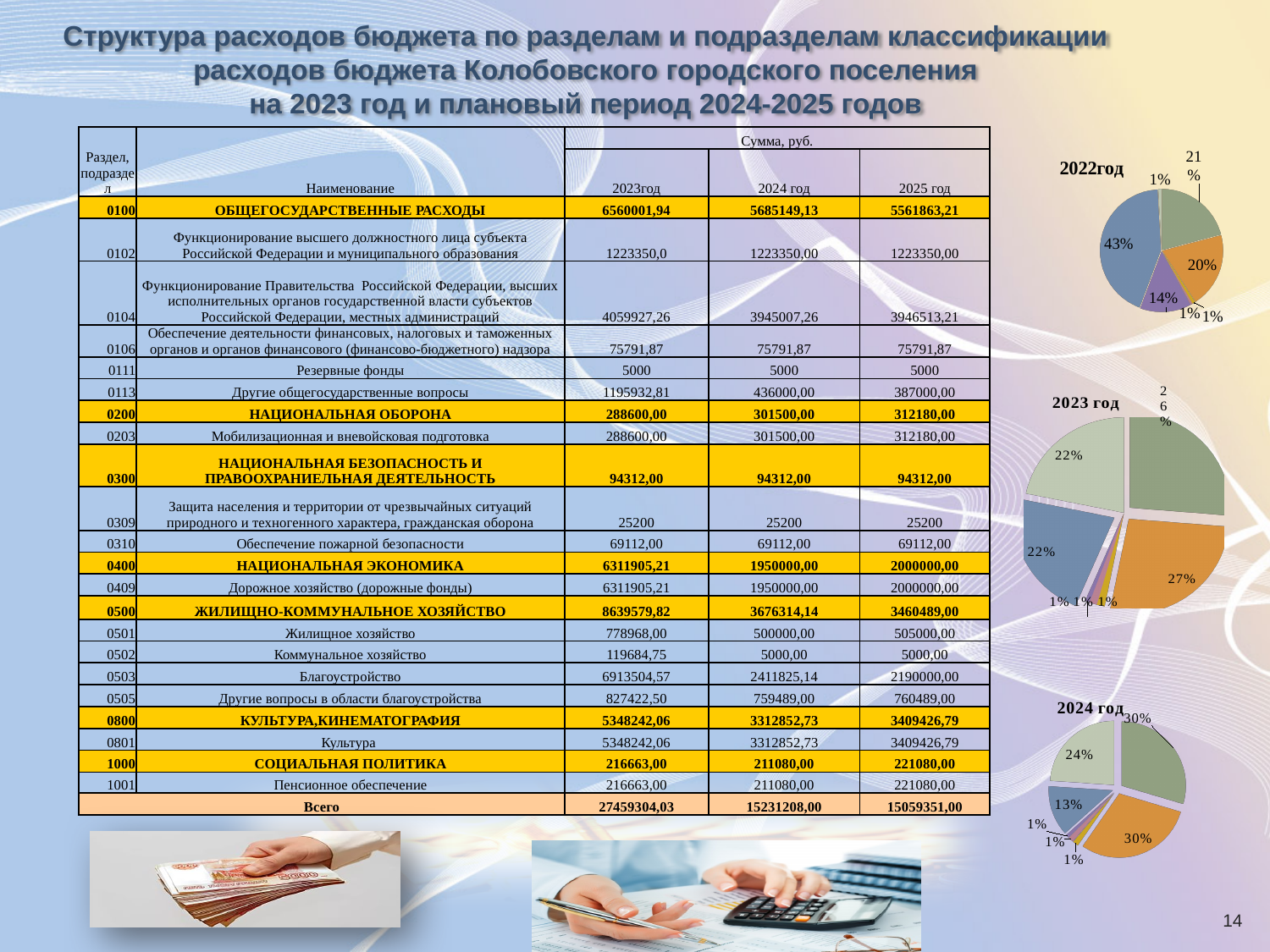
What is the title of the topmost pie chart on the slide? 2022год What is the title of the bottom pie chart on the slide? 2024 год In the "2023 год" pie chart, what is the share of the largest slice? 27% In the "2024 год" pie chart, what share is labelled on the slice between the 24% slice and the 1% slices? 13% In the "2022год" pie chart, what is the share of the smallest labelled slices? 1% In the "2023 год" pie chart, is the largest slice greater or less than 30%? less How many pie charts are shown on the slide? 3 In the "2022год" pie chart, what is the share of the largest slice? 43% What kind of chart is the chart titled "2022год"? pie chart In the "2022год" pie chart, is the largest slice greater or less than 40%? greater In the "2024 год" pie chart, what is the share of the largest slices? 30%